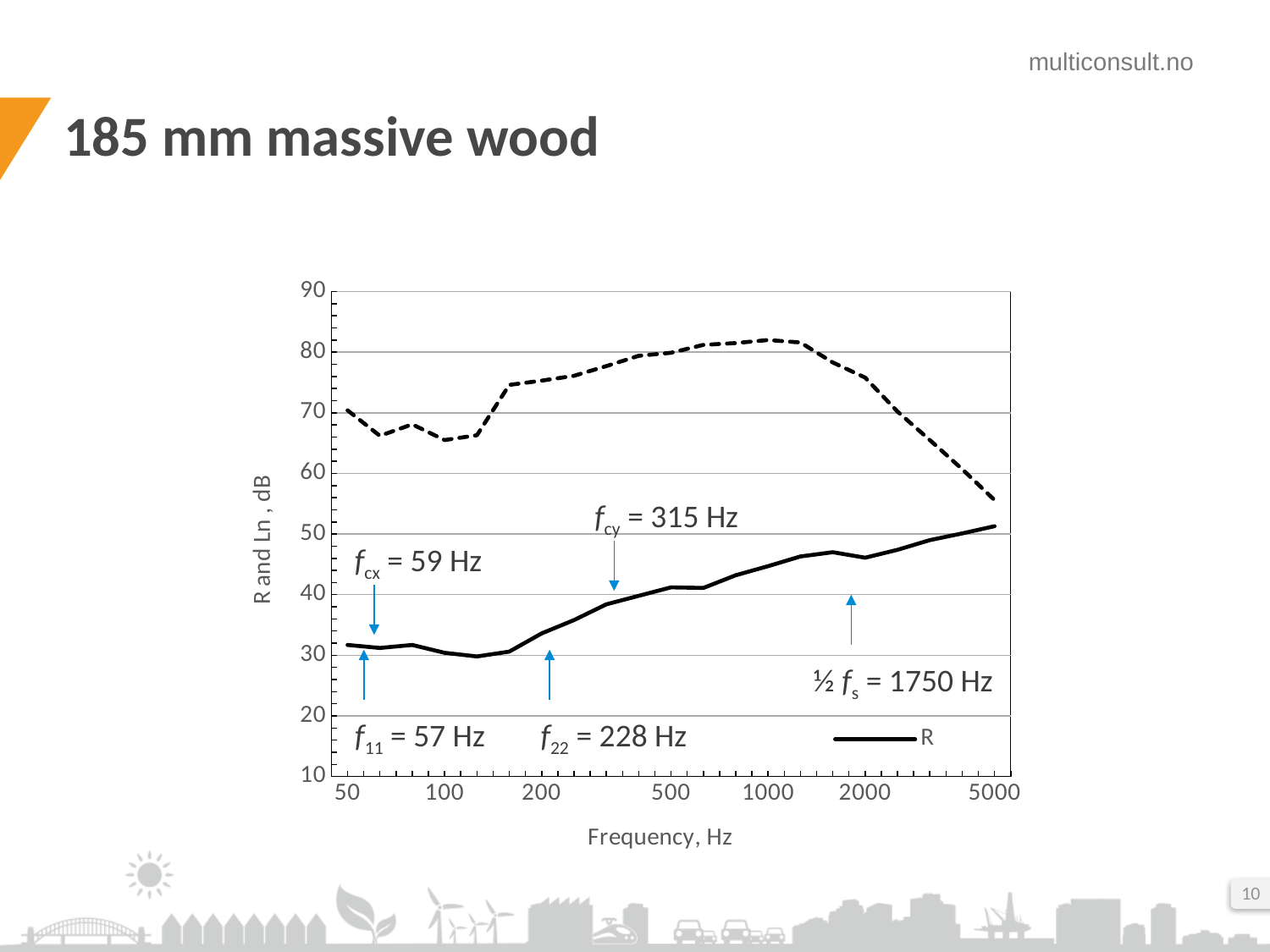
What kind of chart is shown on the slide? line chart At 1000 Hz, which line has the higher value, the solid R line or the dashed line? the dashed line How many series does the chart legend list? 1 Does the solid R line generally rise or fall as frequency increases from 200 Hz to 5000 Hz? rise Is the value of the solid R line at 50 Hz greater or less than 40? less Is the value of the dashed line at 100 Hz greater or less than 70? less According to the annotation on the chart, what frequency is f_cy? 315 Hz Is the value of the dashed line at 1000 Hz greater or less than 80? greater What is the title of the x axis of the chart? Frequency, Hz What is the title of the y axis of the chart? R and Ln , dB